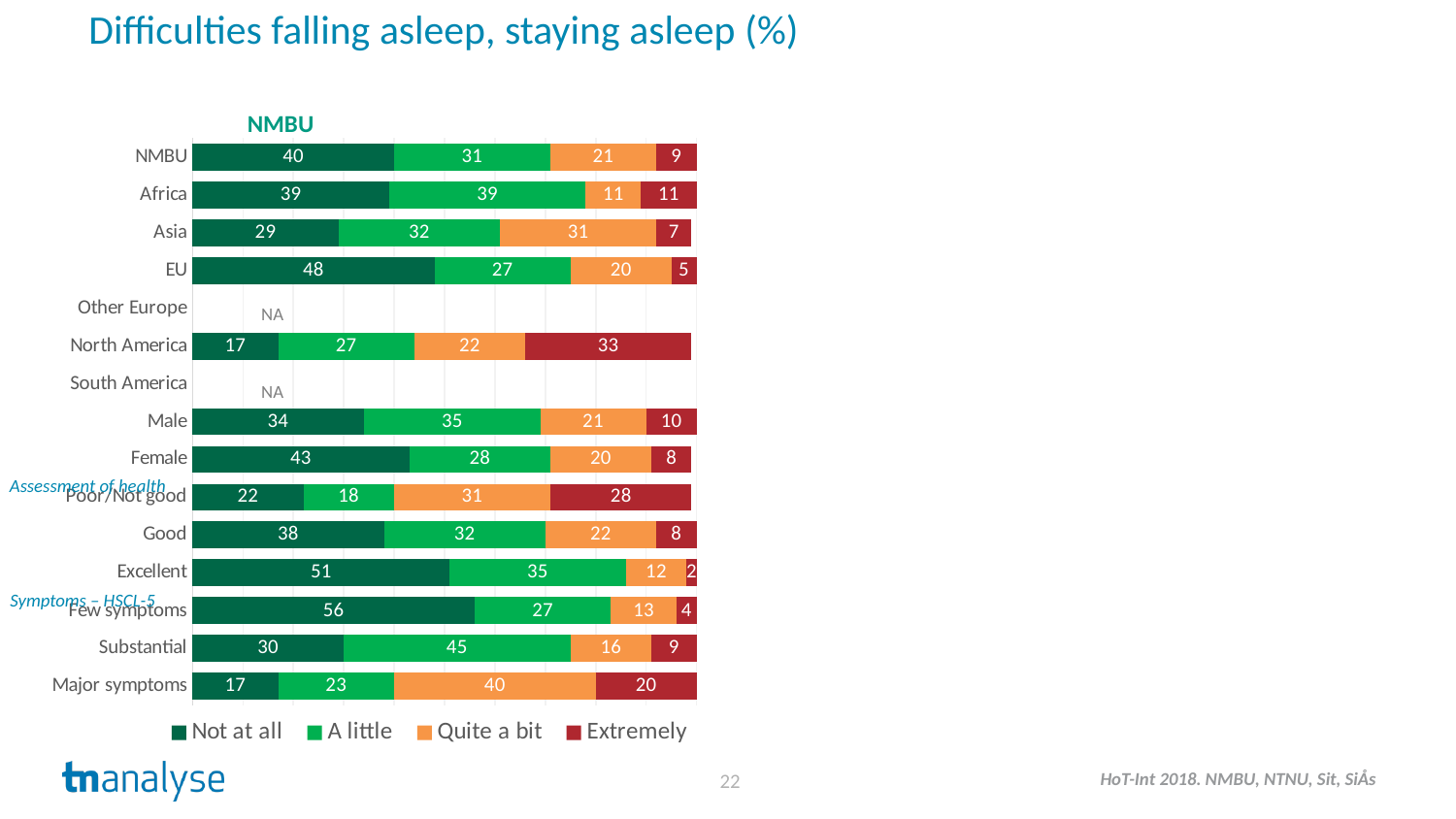
What is the 'Quite a bit' value for Major symptoms? 40 Which category has the lowest 'Extremely' value? Excellent What kind of chart is shown on the slide? Stacked bar chart What is the 'Extremely' value for North America? 33 What is the 'Extremely' value for Poor/Not good? 28 What is the difference between the 'Not at all' values for Female and Male? 9 How many series does the legend list? 4 What is the total of the stacked bar for Africa? 100 What is the 'Not at all' value for EU? 48 Which category has the highest 'Not at all' value? Few symptoms Which is larger, the 'A little' value for Substantial or for Asia? Substantial Which categories are marked NA in the chart? Other Europe and South America